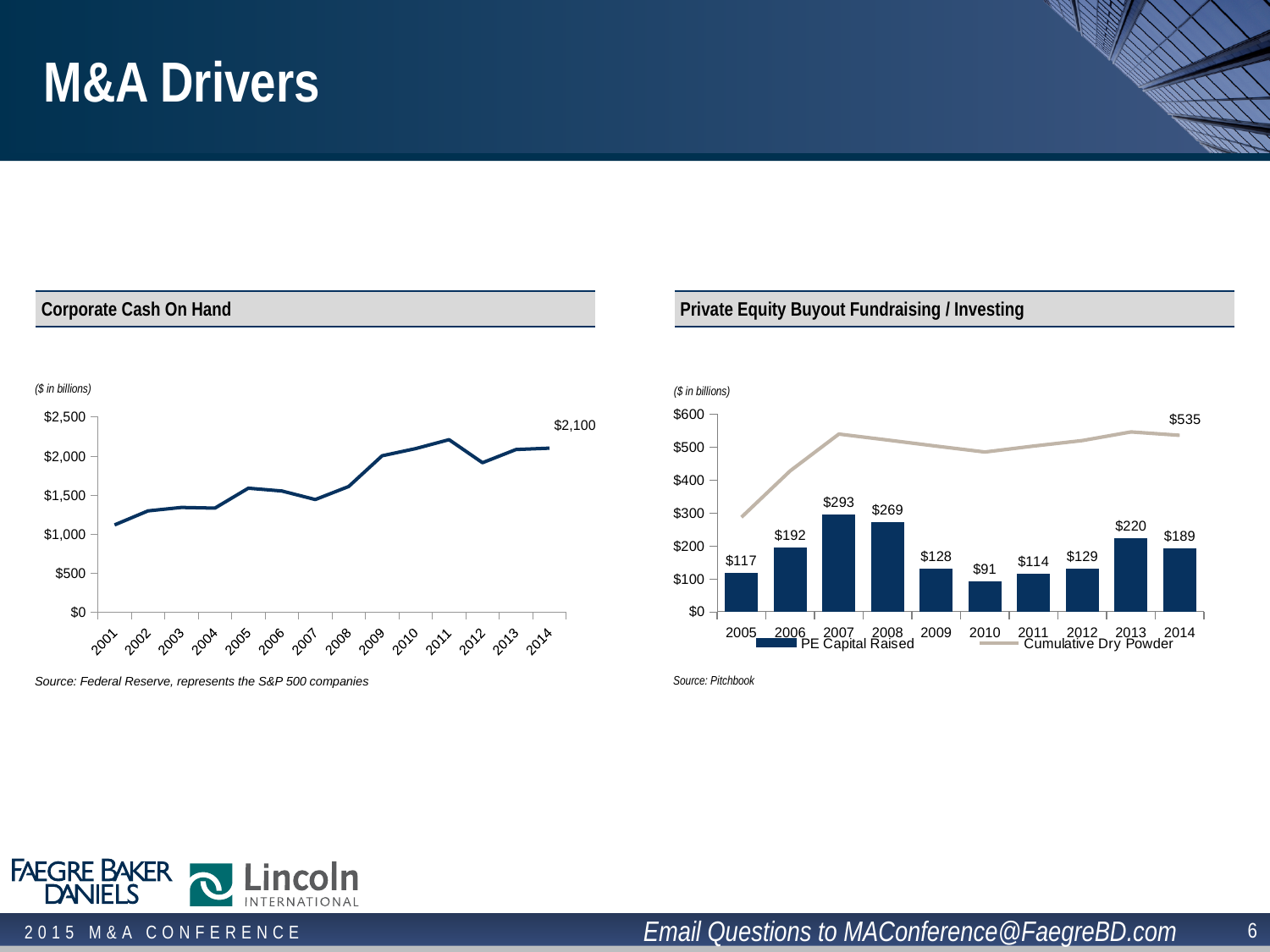
In the Corporate Cash On Hand chart, is the value for 2011 greater or less than $2,000? greater In the Private Equity Buyout Fundraising / Investing chart, which year has the highest PE Capital Raised? 2007 What kind of chart is the Corporate Cash On Hand chart? line chart In the Private Equity Buyout Fundraising / Investing chart, what is the difference in PE Capital Raised between 2013 and 2014? $31 How many series does the legend of the Private Equity Buyout Fundraising / Investing chart list? 2 In the Corporate Cash On Hand chart, what is the value for 2014? $2,100 In the Corporate Cash On Hand chart, is the value for 2001 greater or less than $1,500? less In the Private Equity Buyout Fundraising / Investing chart, what is the Cumulative Dry Powder value for 2014? $535 In the Private Equity Buyout Fundraising / Investing chart, what is the PE Capital Raised value for 2007? $293 In the Corporate Cash On Hand chart, do values generally rise or fall from 2001 to 2014? rise In the Private Equity Buyout Fundraising / Investing chart, which year has the lowest PE Capital Raised? 2010 In the Corporate Cash On Hand chart, how many years are shown on the x axis? 14